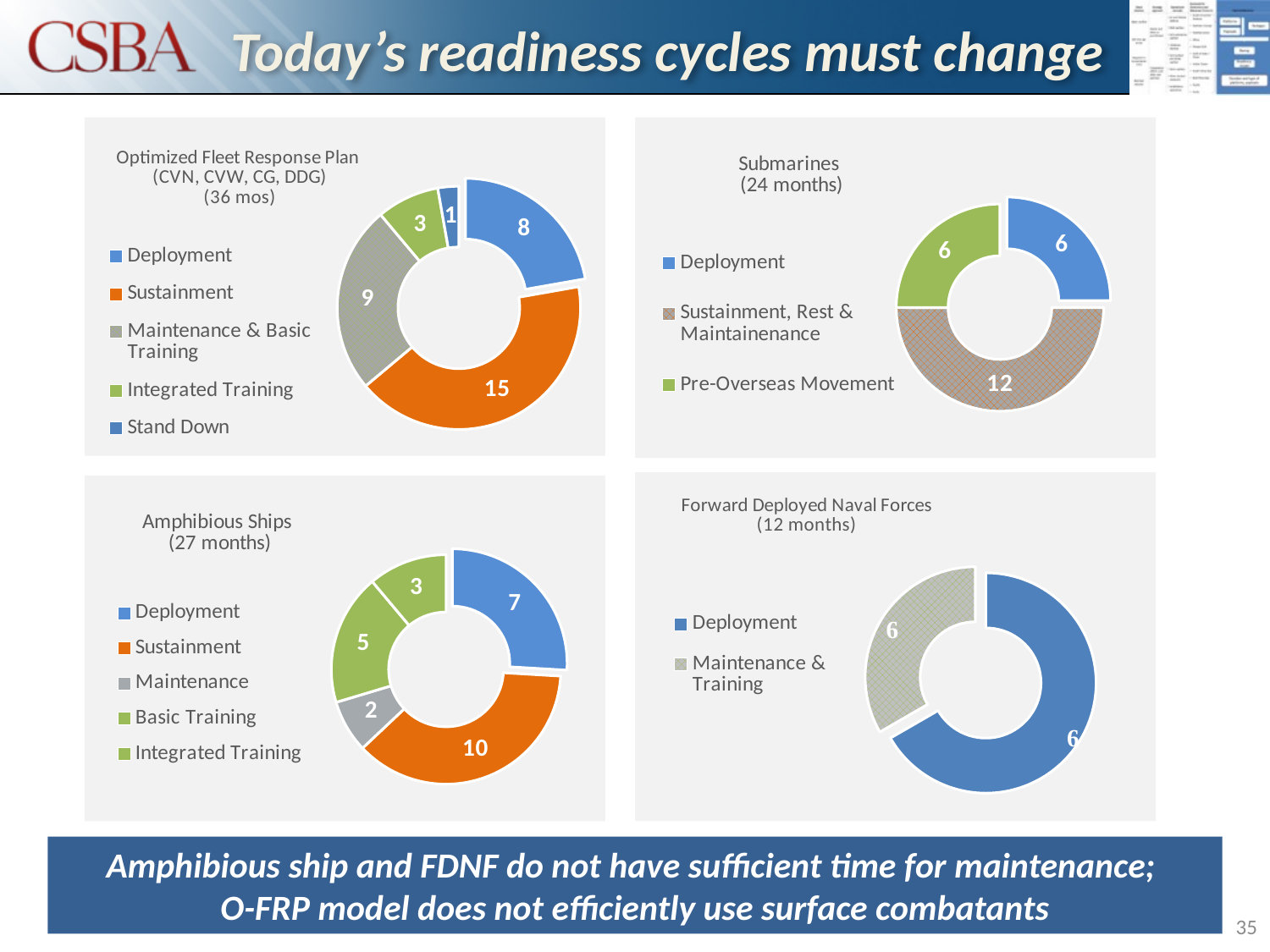
In the Submarines chart, what share of the total does Deployment represent? 25% In the Submarines chart, what value is shown for Sustainment, Rest & Maintainenance? 12 In the Amphibious Ships chart, what value is shown for Maintenance? 2 In the Submarines chart, which category has the largest value? Sustainment, Rest & Maintainenance In the Optimized Fleet Response Plan chart, what is the difference between Sustainment and Deployment? 7 In the Forward Deployed Naval Forces chart, what value is shown for Maintenance & Training? 6 In the Optimized Fleet Response Plan chart, which category has the smallest value? Stand Down In the Optimized Fleet Response Plan chart, what value is shown for Sustainment? 15 How many categories does the legend of the Optimized Fleet Response Plan chart list? 5 In the Amphibious Ships chart, what is the total of all segments? 27 In the Amphibious Ships chart, which is larger, Basic Training or Integrated Training? Basic Training What type of chart is used for the Forward Deployed Naval Forces data? Donut chart